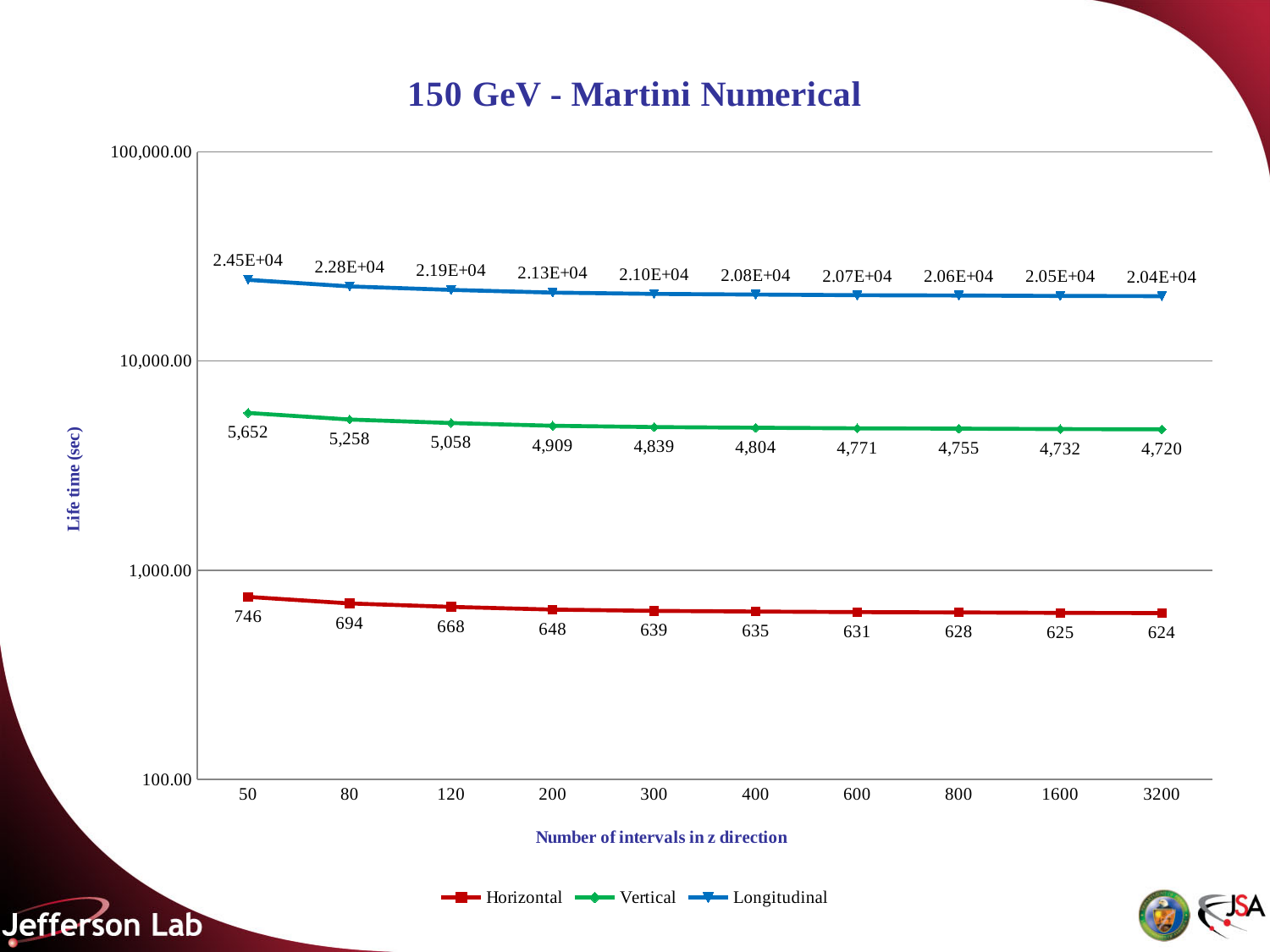
What is the Longitudinal life time at 3200 intervals in z direction? 2.04E+04 What is the difference between the Horizontal life time at 80 intervals and at 120 intervals? 26 What kind of chart is shown on the slide? line chart How many x-axis categories (numbers of intervals) are plotted? 10 Which series has the larger life time at 400 intervals, Vertical or Horizontal? Vertical What is the Horizontal life time at 50 intervals in z direction? 746 What is the difference between the Vertical life time at 50 intervals and at 3200 intervals? 932 Is the Horizontal life time at 50 intervals greater or less than 1,000.00? less How many series does the legend list? 3 At which number of intervals is the Vertical life time highest? 50 At which number of intervals is the Horizontal life time lowest? 3200 What is the Vertical life time at 200 intervals in z direction? 4,909